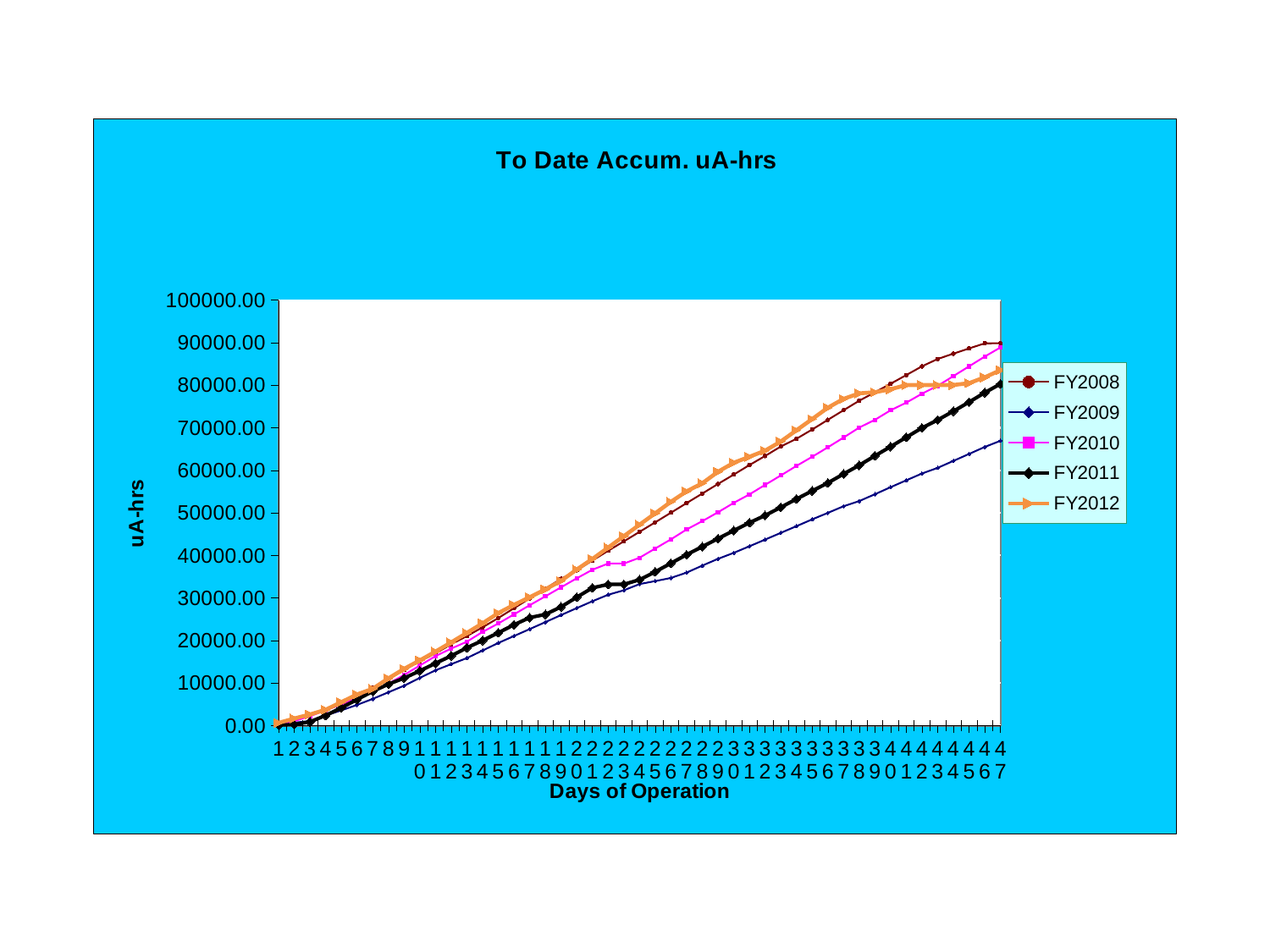
What is the label of the x axis? Days of Operation Do the values for FY2009 rise or fall along the x axis? rise Is the value for FY2008 at day 47 greater or less than 80000.00? greater At day 47, which is larger, the value for FY2012 or the value for FY2009? FY2012 How many days of operation are shown along the x axis? 47 What is the title of the chart? To Date Accum. uA-hrs What kind of chart is shown on the slide? line chart How many series does the legend list? 5 Is the value for FY2009 at day 47 greater or less than 70000.00? less Which series has the lowest value at day 47? FY2009 Is the value for FY2011 at day 20 greater or less than 40000.00? less Do the values for FY2012 rise or fall as the days of operation increase? rise